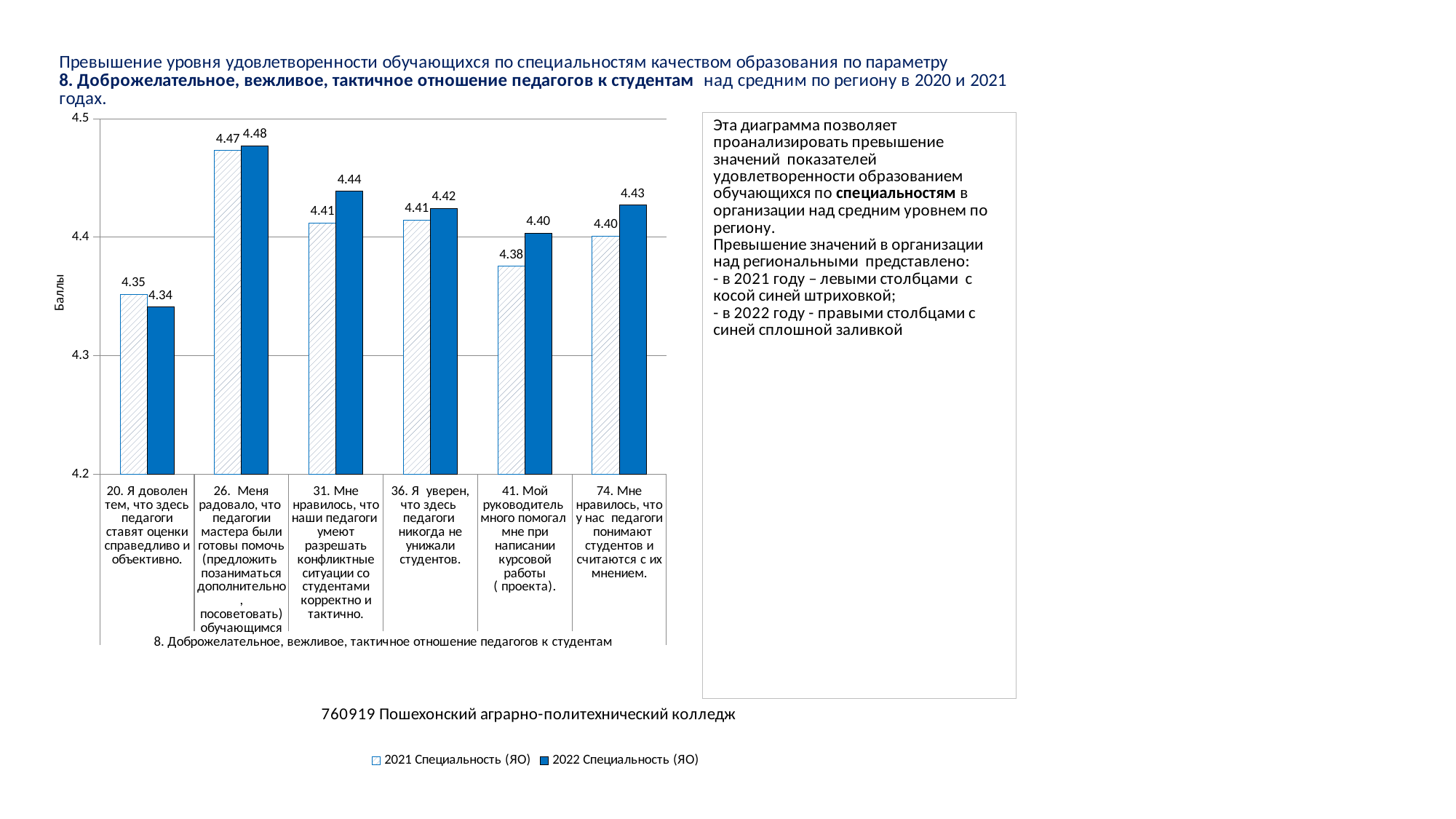
For item 20 (Я доволен тем, что здесь педагоги ставят оценки справедливо), which is larger: the 2021 value or the 2022 value? 2021 (4.35) What is the 2021 Специальность (ЯО) value for item 41 (Мой руководитель много помогал мне при написании курсовой работы)? 4.38 What is the 2022 Специальность (ЯО) value for item 26 (Меня радовало, что педагоги мастера были готовы помочь)? 4.48 Is the 2021 value for item 41 (Мой руководитель много помогал мне) greater or less than 4.3? greater What type of chart is shown on the slide? bar chart How many series does the chart legend list? 2 What is the label of the vertical axis of the chart? Баллы Which item has the highest 2022 Специальность (ЯО) value? 26. Меня радовало, что педагоги мастера были готовы помочь How many items (categories) are shown on the x axis of the chart? 6 What is the difference between the 2022 and 2021 values for item 31 (Мне нравилось, что наши педагоги умеют разрешать конфликтные ситуации)? 0.03 What is the 2021 Специальность (ЯО) value for item 74 (Мне нравилось, что у нас педагоги понимают студентов)? 4.40 Which item has the lowest 2022 Специальность (ЯО) value? 20. Я доволен тем, что здесь педагоги ставят оценки справедливо и объективно